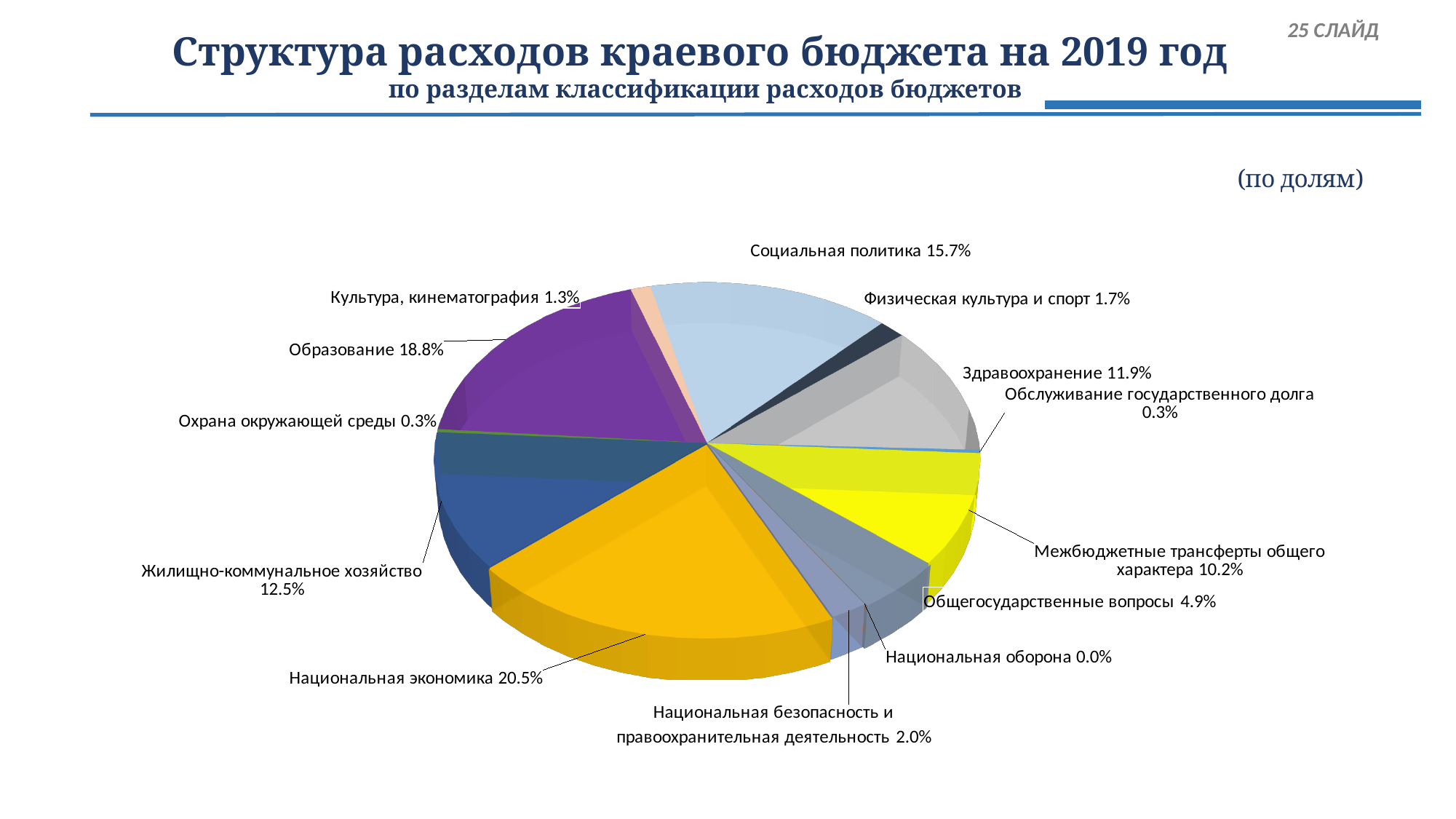
What share is shown for Межбюджетные трансферты общего характера? 10.2% What share is shown for Образование? 18.8% Which section has the largest share of the budget expenditures? Национальная экономика What is the difference in share between Национальная экономика and Образование? 1.7% What share of the pie chart is labelled for Национальная экономика? 20.5% Which section has the smallest share of the budget expenditures? Национальная оборона What share is shown for Здравоохранение? 11.9% Which has a larger share: Здравоохранение or Жилищно-коммунальное хозяйство? Жилищно-коммунальное хозяйство What is the title of the chart on the slide? Структура расходов краевого бюджета на 2019 год по разделам классификации расходов бюджетов What type of chart is shown on the slide? Pie chart What is the difference in share between Социальная политика and Жилищно-коммунальное хозяйство? 3.2%